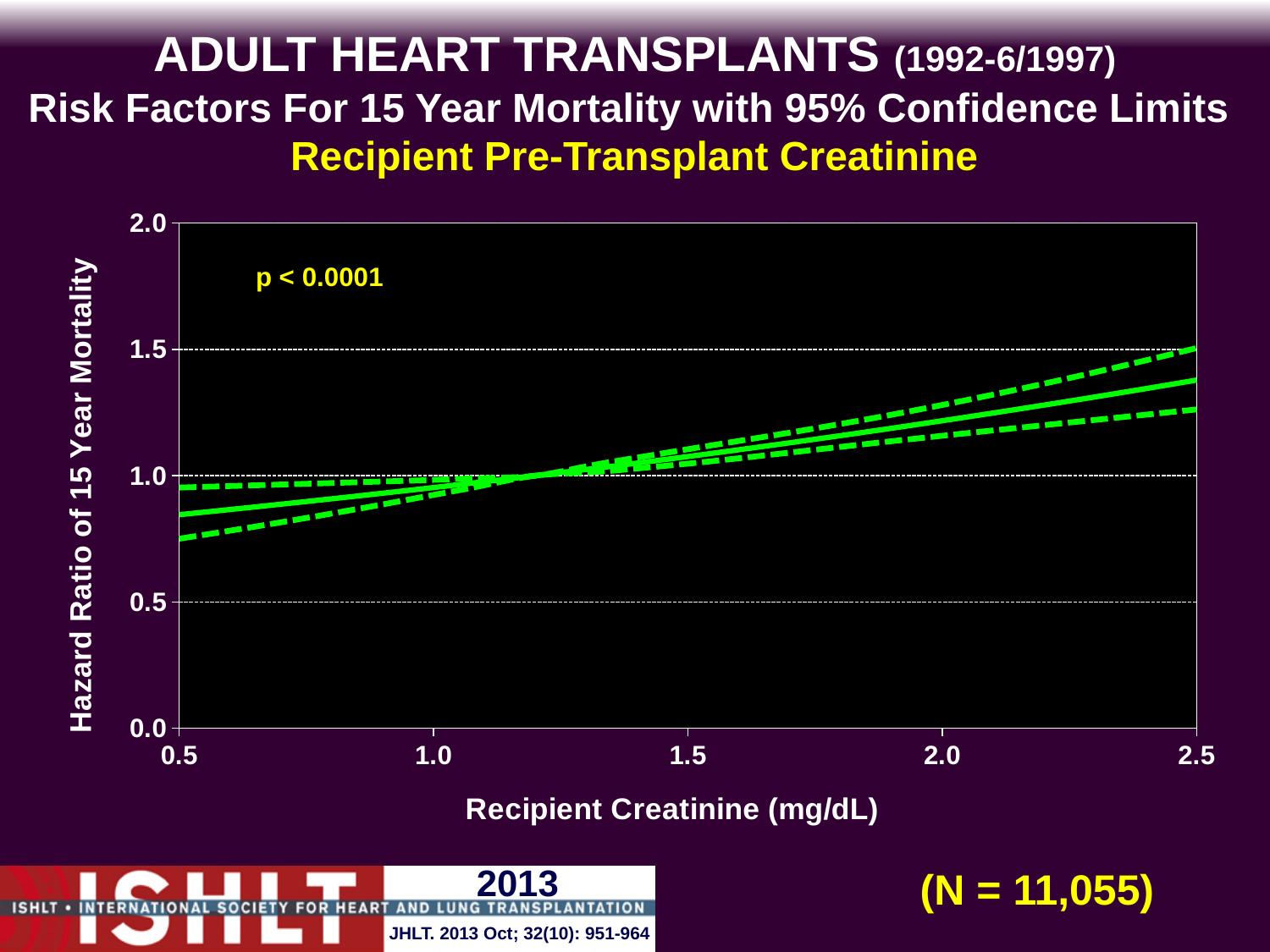
Is the hazard ratio for a recipient creatinine of 2.0 mg/dL greater or less than 1.5? less What p-value is printed on the chart? p < 0.0001 Is the hazard ratio for a recipient creatinine of 0.5 mg/dL greater or less than 1.0? less What kind of chart is shown on the slide? line chart Is the hazard ratio for a recipient creatinine of 1.0 mg/dL greater or less than 0.5? greater Which has the higher hazard ratio: a recipient creatinine of 1.0 mg/dL or 2.0 mg/dL? 2.0 mg/dL How many lines are plotted on the chart? 3 Does the hazard ratio of 15 year mortality rise or fall as recipient creatinine increases along the x axis? rise What is the label of the x axis? Recipient Creatinine (mg/dL)